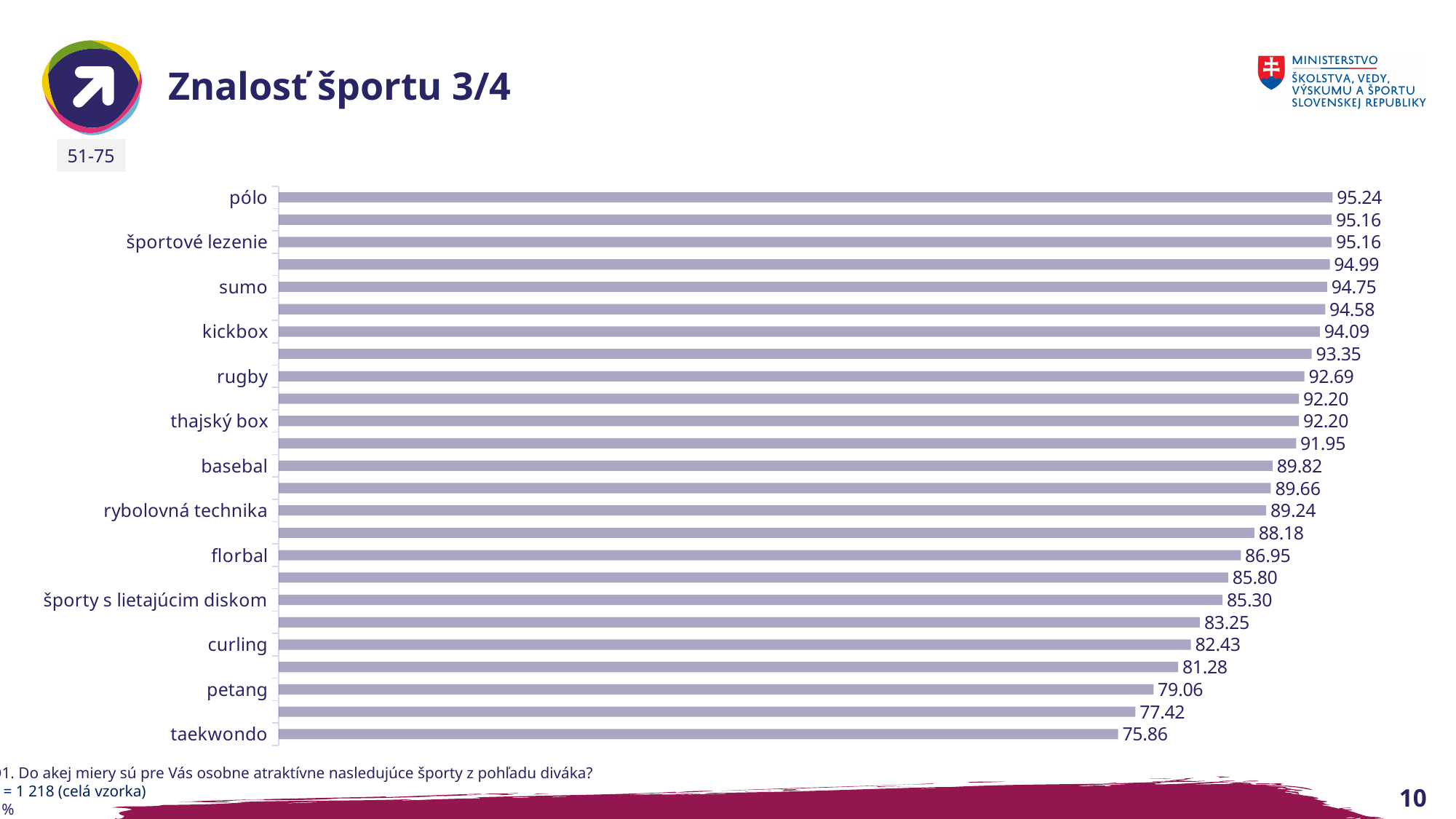
Which labelled category has the highest value? pólo How many bars are plotted in the chart? 25 Which labelled category has the lowest value? taekwondo What is the value for rugby? 92.69 What type of chart is shown on the slide? bar chart What is the title of the slide containing the chart? Znalosť športu 3/4 What is the difference between the values for pólo and taekwondo? 19.38 What is the value for taekwondo? 75.86 Which has a larger value, kickbox or basebal? kickbox What is the value for curling? 82.43 What is the value for pólo? 95.24 What is the value for športy s lietajúcim diskom? 85.30